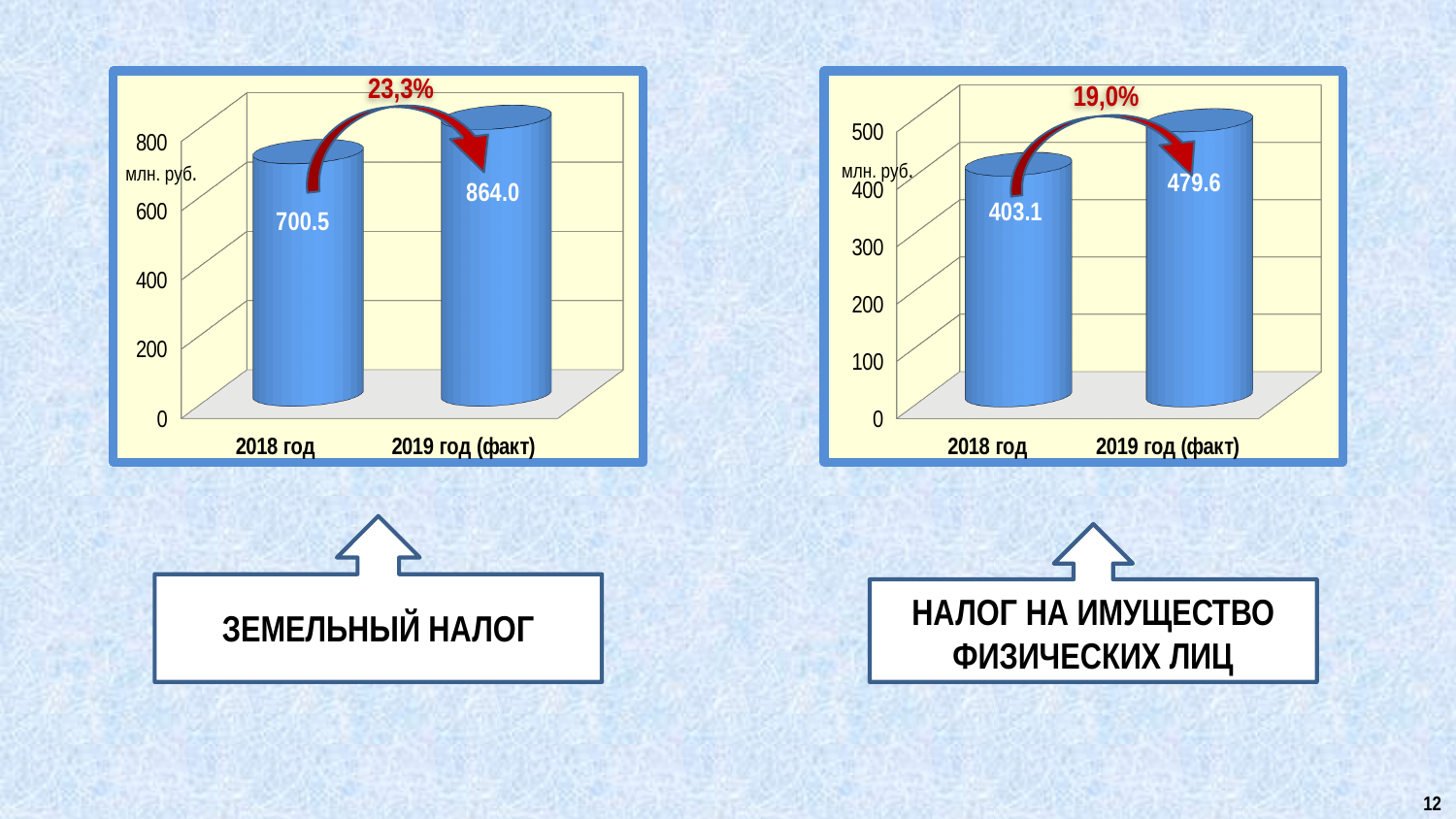
In the right chart (НАЛОГ НА ИМУЩЕСТВО ФИЗИЧЕСКИХ ЛИЦ), what is the difference between the 2019 год (факт) and 2018 год values? 76.5 In the left chart (ЗЕМЕЛЬНЫЙ НАЛОГ), what is the value for 2019 год (факт)? 864.0 In the right chart (НАЛОГ НА ИМУЩЕСТВО ФИЗИЧЕСКИХ ЛИЦ), do the values rise or fall from 2018 год to 2019 год (факт)? rise What kind of chart is the left chart (ЗЕМЕЛЬНЫЙ НАЛОГ)? bar chart In the right chart (НАЛОГ НА ИМУЩЕСТВО ФИЗИЧЕСКИХ ЛИЦ), what is the value for 2019 год (факт)? 479.6 In the left chart (ЗЕМЕЛЬНЫЙ НАЛОГ), what is the value for 2018 год? 700.5 In the left chart (ЗЕМЕЛЬНЫЙ НАЛОГ), what percentage change is shown by the red arrow? 23,3% In the left chart (ЗЕМЕЛЬНЫЙ НАЛОГ), what is the difference between the 2019 год (факт) and 2018 год values? 163.5 In the right chart (НАЛОГ НА ИМУЩЕСТВО ФИЗИЧЕСКИХ ЛИЦ), what percentage change is shown by the red arrow? 19,0% In the left chart (ЗЕМЕЛЬНЫЙ НАЛОГ), which category has the higher value? 2019 год (факт) In the right chart (НАЛОГ НА ИМУЩЕСТВО ФИЗИЧЕСКИХ ЛИЦ), which category has the lower value? 2018 год In the right chart (НАЛОГ НА ИМУЩЕСТВО ФИЗИЧЕСКИХ ЛИЦ), what is the value for 2018 год? 403.1